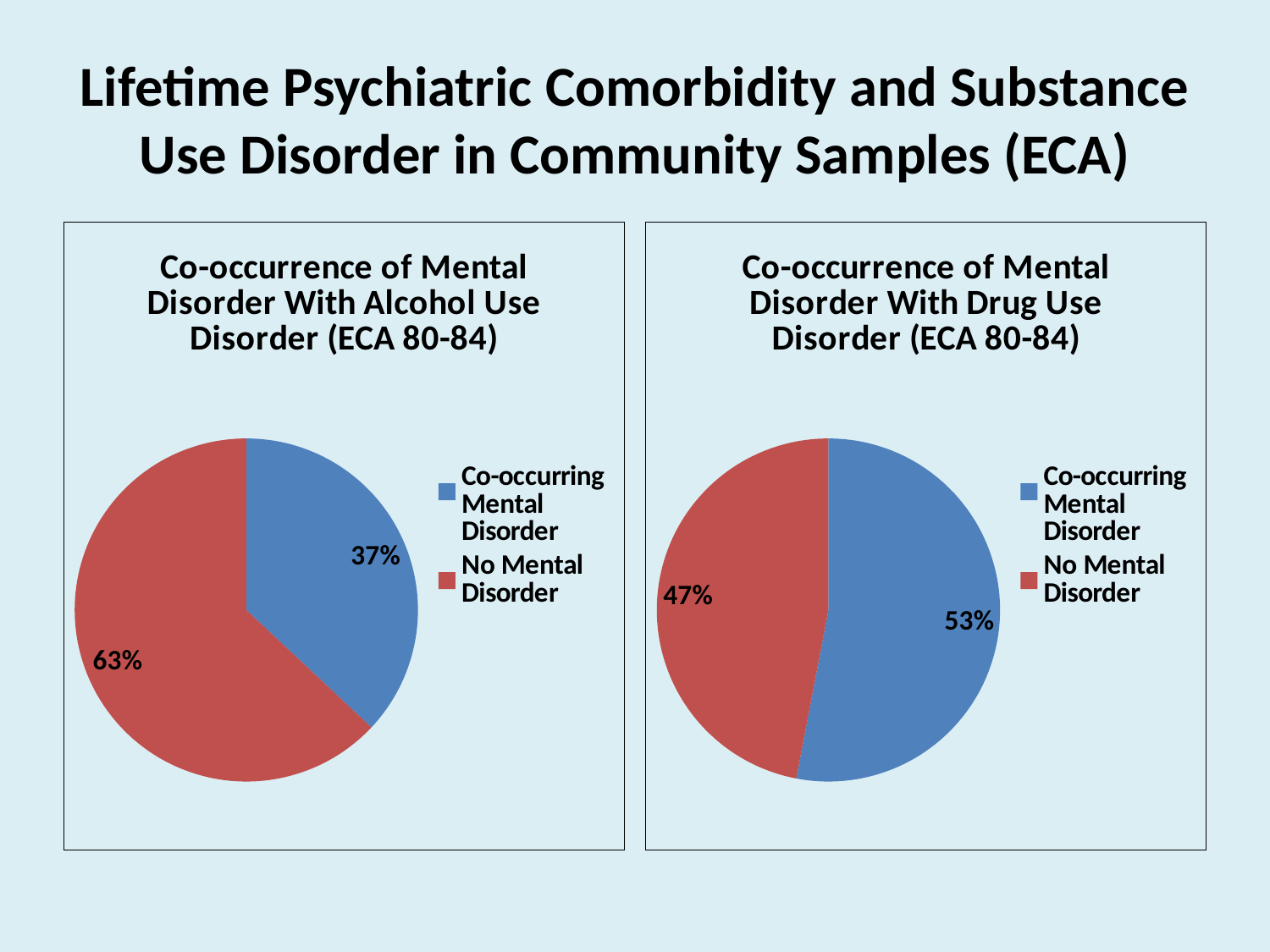
What is the title of the left chart? Co-occurrence of Mental Disorder With Alcohol Use Disorder (ECA 80-84) In the left chart (Alcohol Use Disorder), which slice is the largest? No Mental Disorder In the right chart (Drug Use Disorder), what share of the pie is No Mental Disorder? 47% In the right chart (Drug Use Disorder), what share of the pie is Co-occurring Mental Disorder? 53% What type of chart is used on the left side of the slide? Pie chart In the left chart (Alcohol Use Disorder), what share of the pie is Co-occurring Mental Disorder? 37% Which chart shows a larger share for Co-occurring Mental Disorder, the left (Alcohol Use Disorder) or the right (Drug Use Disorder)? Right (Drug Use Disorder) How many slices does the right chart (Drug Use Disorder) have? 2 In the left chart (Alcohol Use Disorder), what is the difference between the No Mental Disorder and Co-occurring Mental Disorder shares? 26% In the right chart (Drug Use Disorder), what is the difference between the Co-occurring Mental Disorder and No Mental Disorder shares? 6% In the right chart (Drug Use Disorder), which slice is the smallest? No Mental Disorder